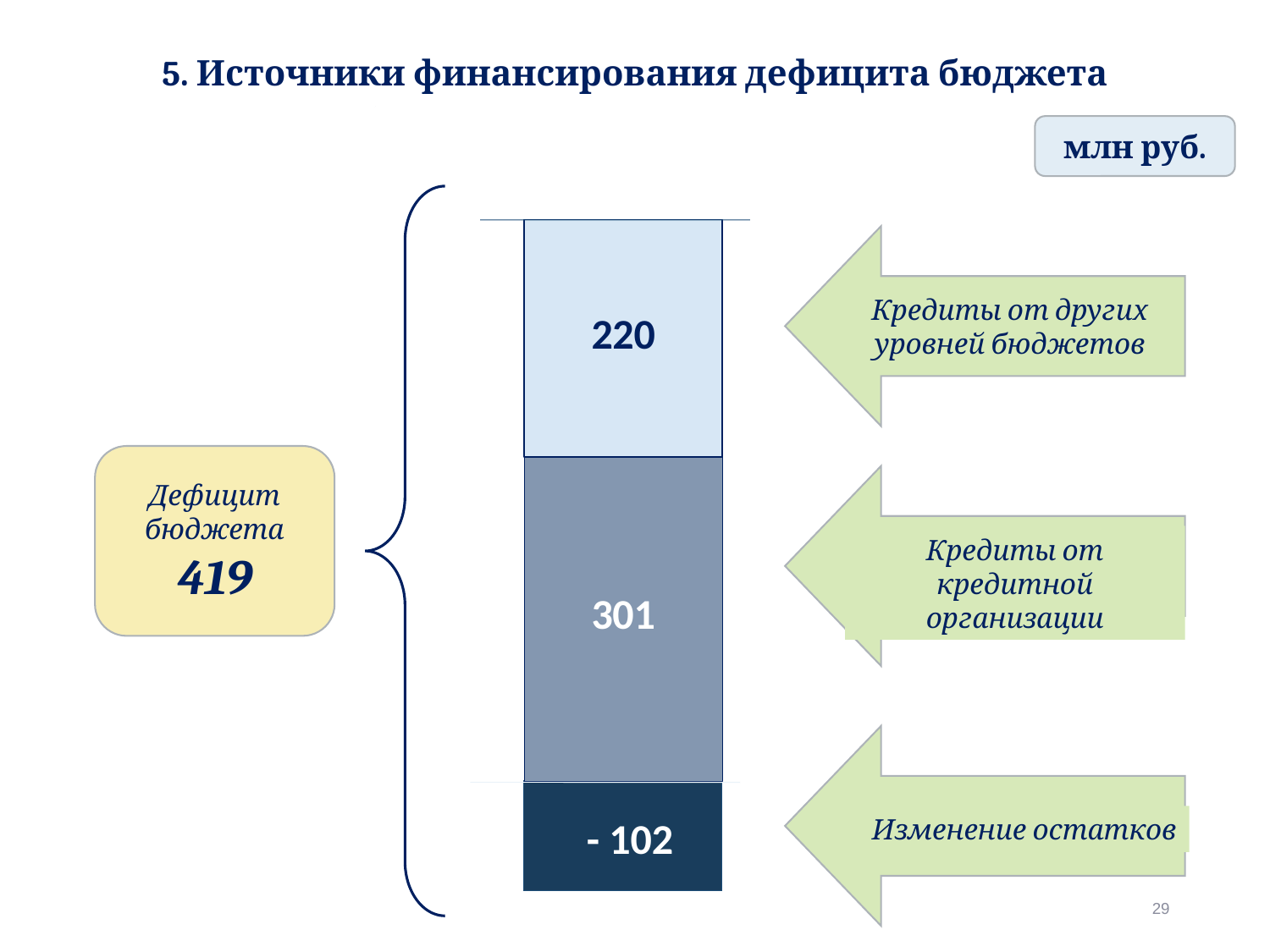
What is the difference between the values for "Кредиты от кредитной организации" and "Кредиты от других уровней бюджетов"? 81 What kind of chart is shown on the slide? Stacked bar chart What is the title of the slide containing the chart? 5. Источники финансирования дефицита бюджета Which source of deficit financing has the largest value in the bar? Кредиты от кредитной организации Which is larger: the value for "Кредиты от других уровней бюджетов" or the value for "Кредиты от кредитной организации"? Кредиты от кредитной организации What is the value for "Кредиты от других уровней бюджетов" in the stacked bar? 220 Which source of deficit financing has the lowest value in the bar? Изменение остатков What is the total of the stacked bar (the budget deficit)? 419 What is the value for "Изменение остатков" in the stacked bar? - 102 How many segments make up the stacked bar? 3 What is the value for "Кредиты от кредитной организации" in the stacked bar? 301 In what units are the values on the chart given? млн руб.